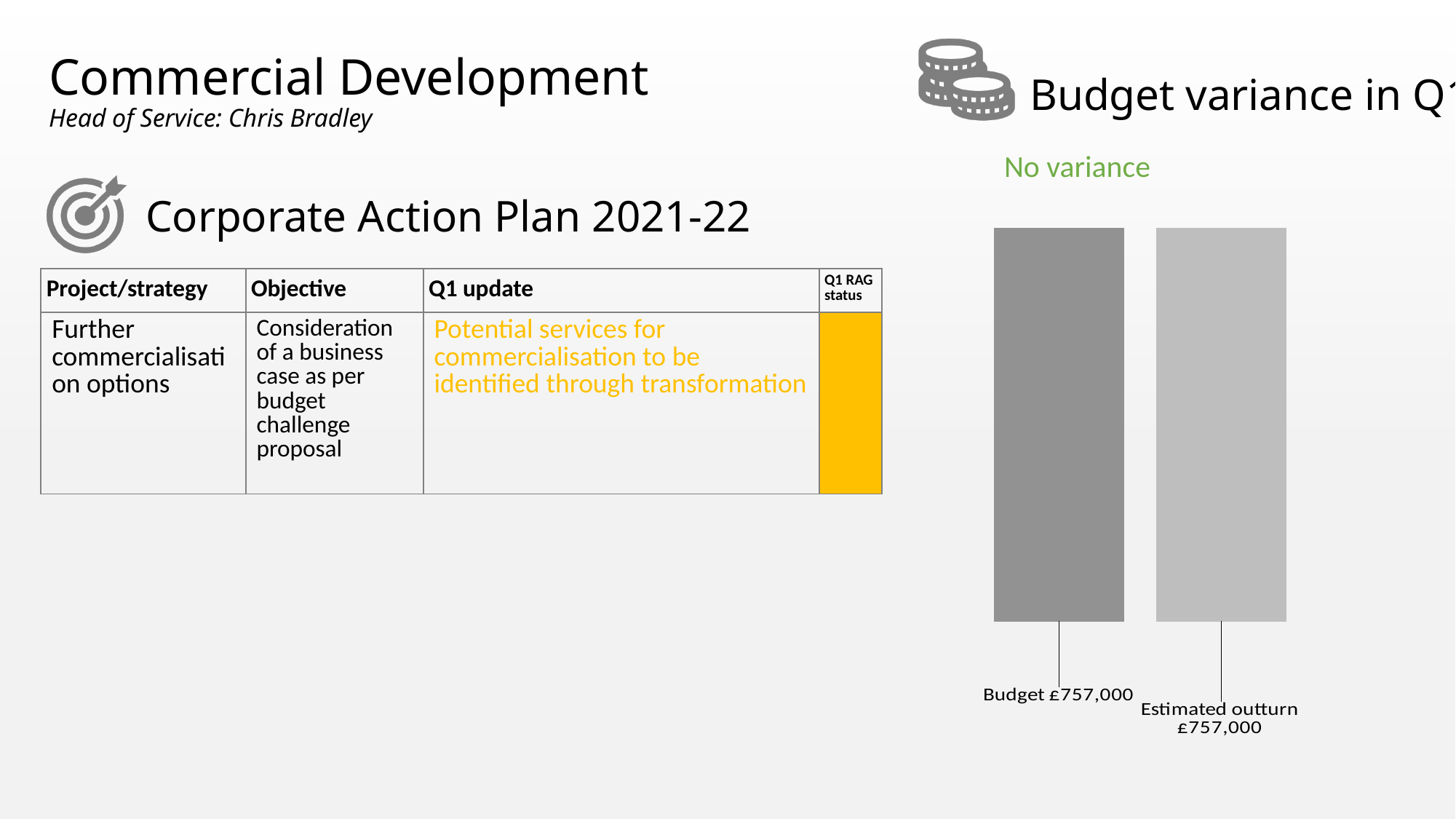
What text is shown in green above the budget variance chart? No variance Is the Estimated outturn value in the budget variance chart greater or less than £800,000? less What is the value of the Estimated outturn bar in the budget variance chart? £757,000 What kind of chart is the budget variance chart? bar chart Is the Budget value in the budget variance chart greater or less than £700,000? greater What is the value of the Budget bar in the budget variance chart? £757,000 What is the difference between the Budget and Estimated outturn values in the budget variance chart? £0 What are the two category labels in the budget variance chart? Budget and Estimated outturn How many bars are plotted in the budget variance chart? 2